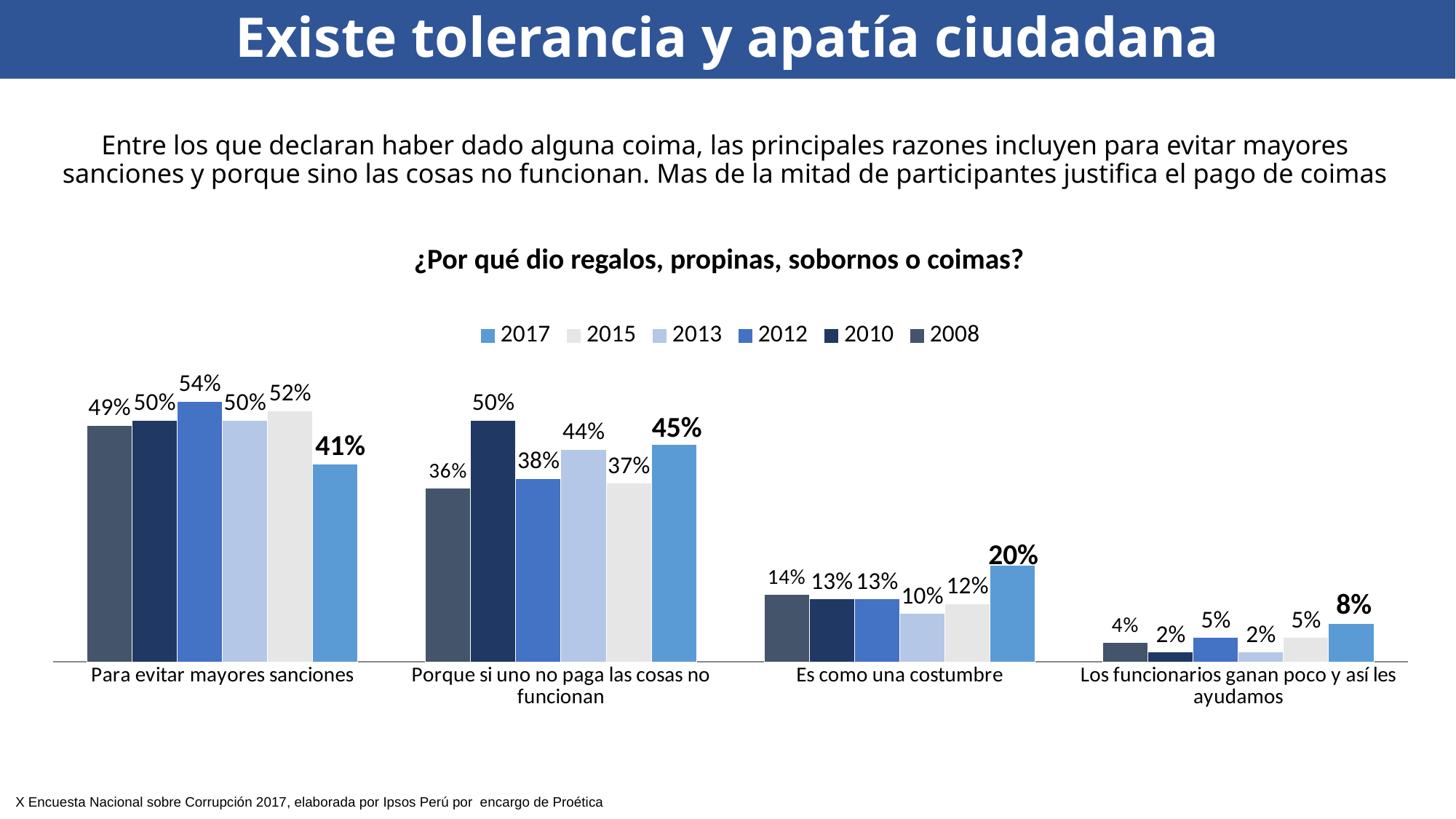
What is the title of the chart? ¿Por qué dio regalos, propinas, sobornos o coimas? What is the 2008 value for "Los funcionarios ganan poco y así les ayudamos"? 4% How many categories are shown on the x axis? 4 What kind of chart is shown on the slide? Bar chart What is the 2017 value for "Para evitar mayores sanciones"? 41% What is the difference between the 2017 and 2015 values for "Es como una costumbre"? 8% Which year has the lowest value for "Porque si uno no paga las cosas no funcionan"? 2008 Which year has the highest value for "Para evitar mayores sanciones"? 2012 What is the 2013 value for "Es como una costumbre"? 10% How many series does the legend list? 6 Which is larger for "Porque si uno no paga las cosas no funcionan": the 2013 value or the 2017 value? 2017 What is the 2010 value for "Porque si uno no paga las cosas no funcionan"? 50%